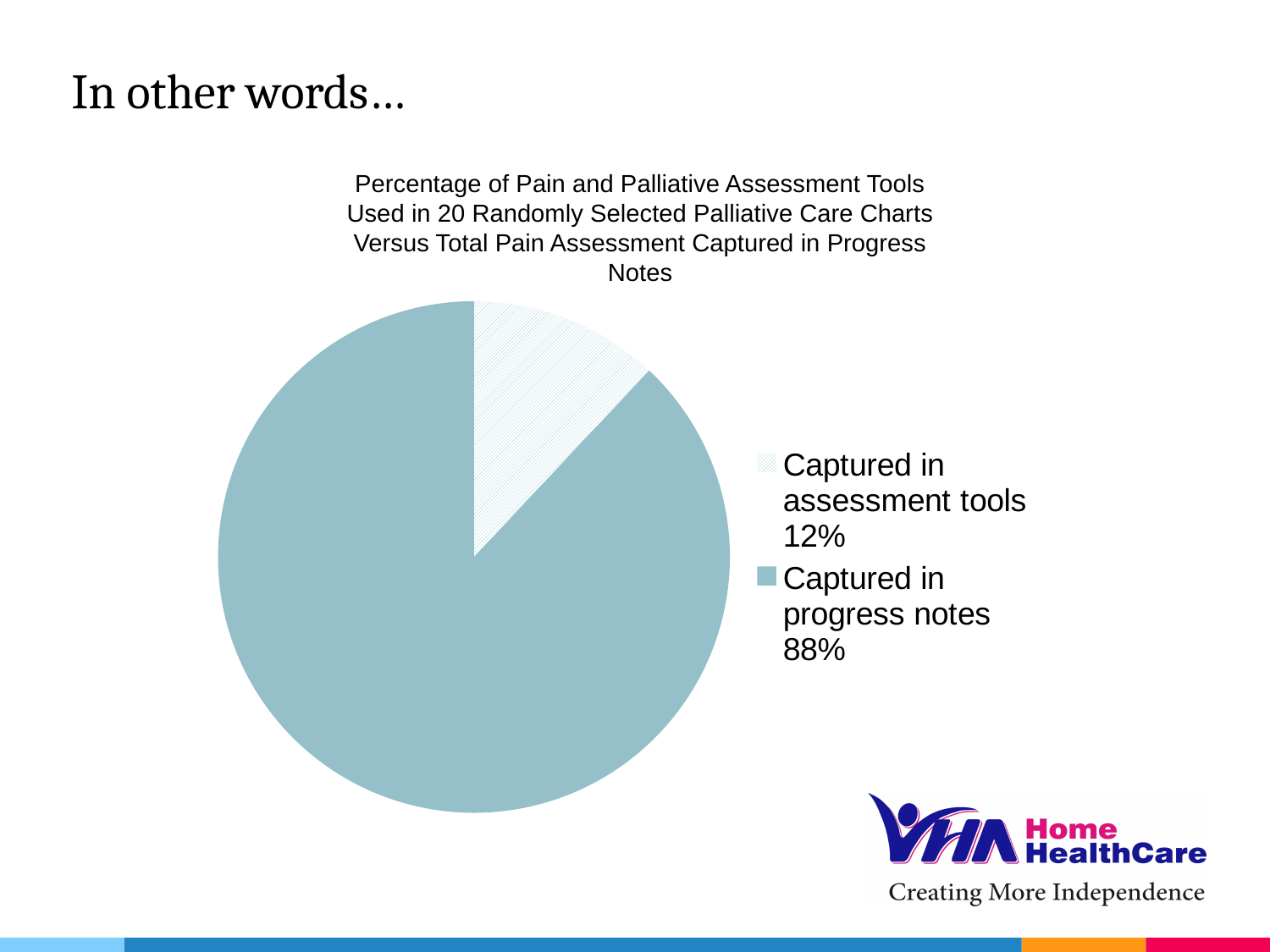
Which slice is shown with a hatched (striped) pattern rather than solid colour? Captured in assessment tools What percentage is shown for 'Captured in assessment tools'? 12% How many entries does the legend list? 2 Which category has the largest share of the pie? Captured in progress notes How many randomly selected palliative care charts does the chart title say were used? 20 Which is larger: the share for 'Captured in assessment tools' or the share for 'Captured in progress notes'? Captured in progress notes What percentage is shown for 'Captured in progress notes'? 88% How many slices does the pie chart have? 2 What kind of chart is shown on the slide? pie chart What share of the pie does 'Captured in progress notes' represent? 88% What is the difference in percentage points between 'Captured in progress notes' and 'Captured in assessment tools'? 76 Which category has the smallest share of the pie? Captured in assessment tools